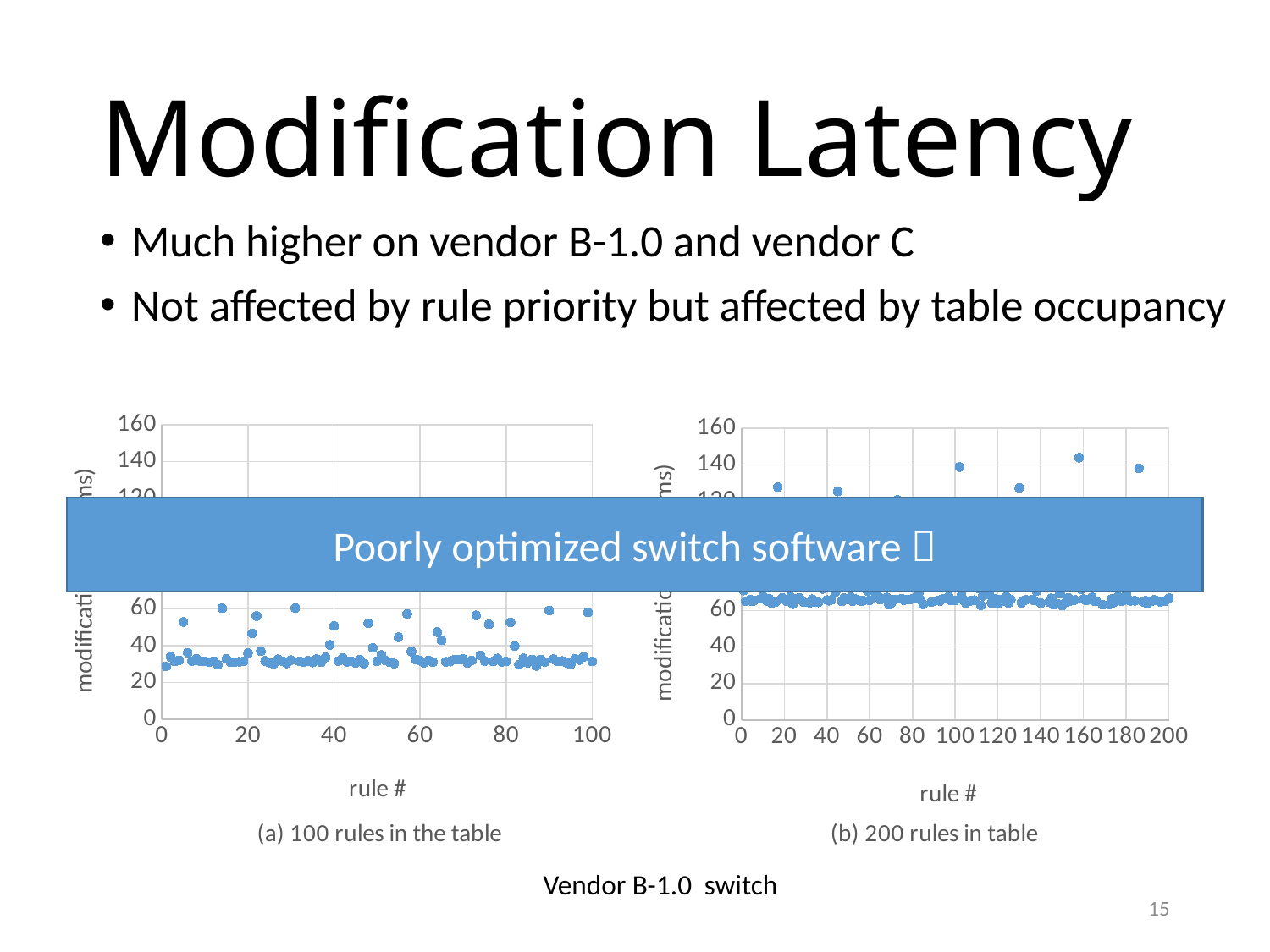
Which switch do the two charts on the slide describe, according to the caption below them? Vendor B-1.0 switch What kind of chart is the right chart, labelled "(b) 200 rules in table"? scatter chart What kind of chart is the left chart, labelled "(a) 100 rules in the table"? scatter chart In the right chart "(b) 200 rules in table", is the value for rule 200 greater or less than 40? greater In the left chart "(a) 100 rules in the table", what is the label of the x axis? rule # In the left chart "(a) 100 rules in the table", is the value for rule 1 greater or less than 60? less In the left chart "(a) 100 rules in the table", is the value for rule 100 greater or less than 40? less In the right chart "(b) 200 rules in table", do the values show a clear rising or falling trend along the x axis, or stay roughly flat? roughly flat In the right chart "(b) 200 rules in table", what is the highest tick value shown on the x axis? 200 In the left chart "(a) 100 rules in the table", what is the highest tick value shown on the y axis? 160 Which chart shows higher typical modification latency values, the left chart "(a) 100 rules in the table" or the right chart "(b) 200 rules in table"? (b) 200 rules in table